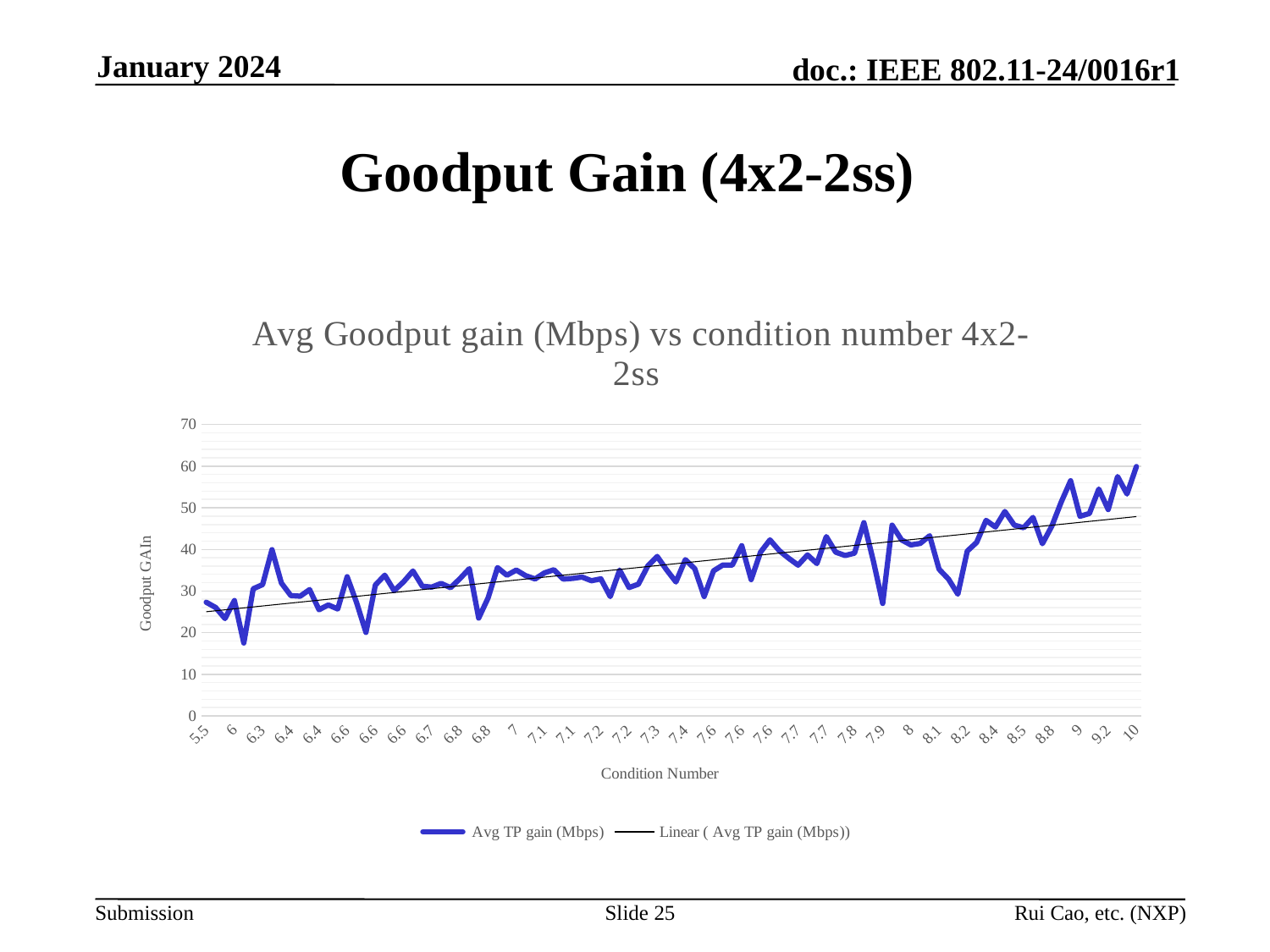
Is the Avg TP gain (Mbps) at condition number 7 greater or less than 40? less How many series does the legend list? 2 What is the label of the x axis? Condition Number Which is larger, the Avg TP gain (Mbps) at condition number 10 or at condition number 5.5? condition number 10 Is the Avg TP gain (Mbps) at condition number 10 greater or less than 50? greater At which condition number is the Avg TP gain (Mbps) highest? 10 What kind of chart is shown on the slide? line chart Is the Avg TP gain (Mbps) at condition number 5.5 greater or less than 30? less What is the title of the chart? Avg Goodput gain (Mbps) vs condition number 4x2-2ss Do the Avg TP gain (Mbps) values generally rise or fall as the condition number increases? rise